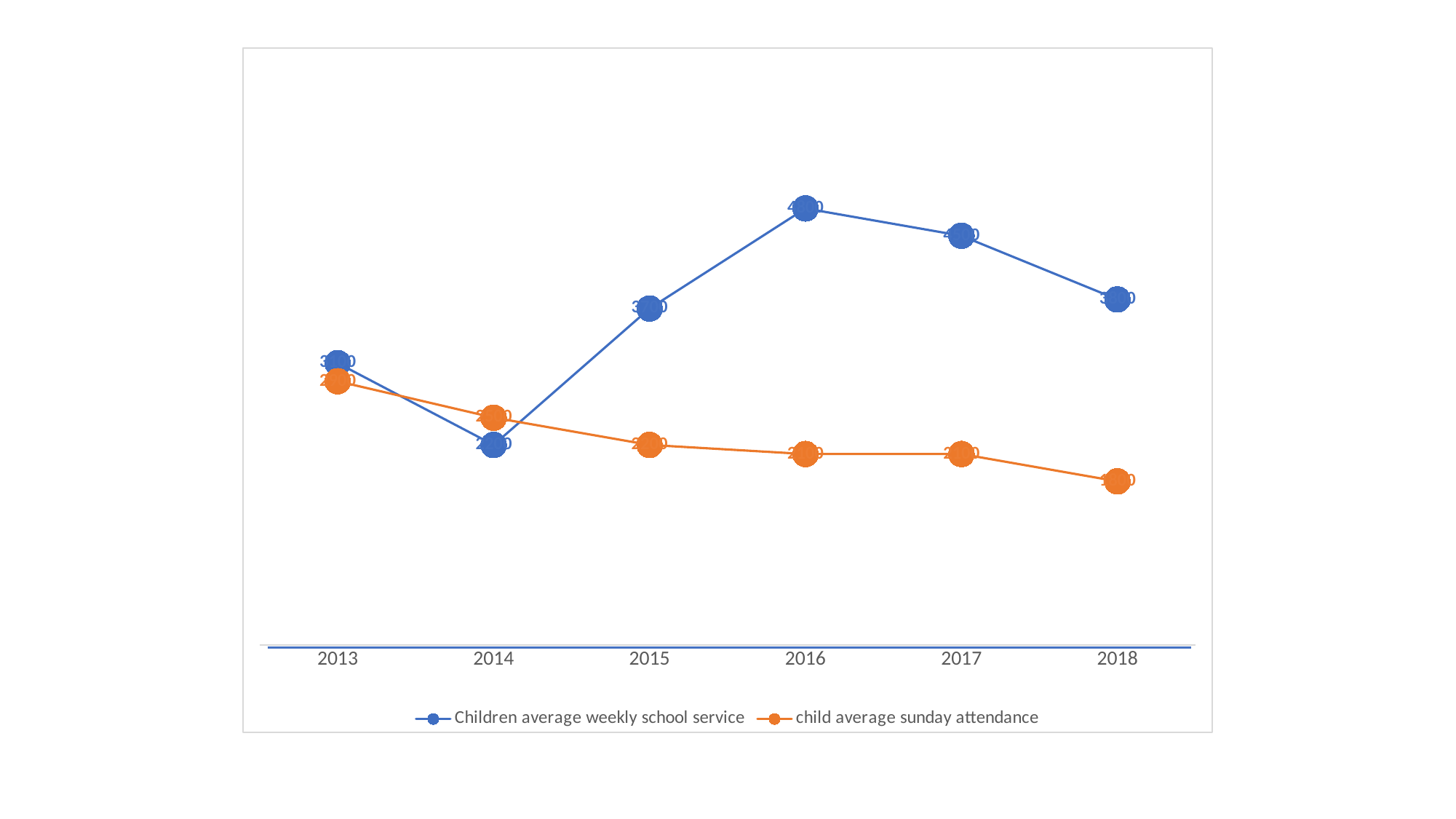
How many series does the legend list? 2 Does the Children average weekly school service series rise or fall from 2016 to 2018? fall In 2016, which series has the larger value: Children average weekly school service or child average sunday attendance? Children average weekly school service In which year is the Children average weekly school service value lowest? 2014 In 2014, which series has the larger value: Children average weekly school service or child average sunday attendance? child average sunday attendance In which year is the child average sunday attendance value lowest? 2018 What kind of chart is shown on the slide? line chart What colour is the line for child average sunday attendance? orange In which year is the Children average weekly school service value highest? 2016 In which year is the child average sunday attendance value highest? 2013 Does the child average sunday attendance series rise or fall from 2013 to 2018? fall How many years are plotted along the x axis? 6